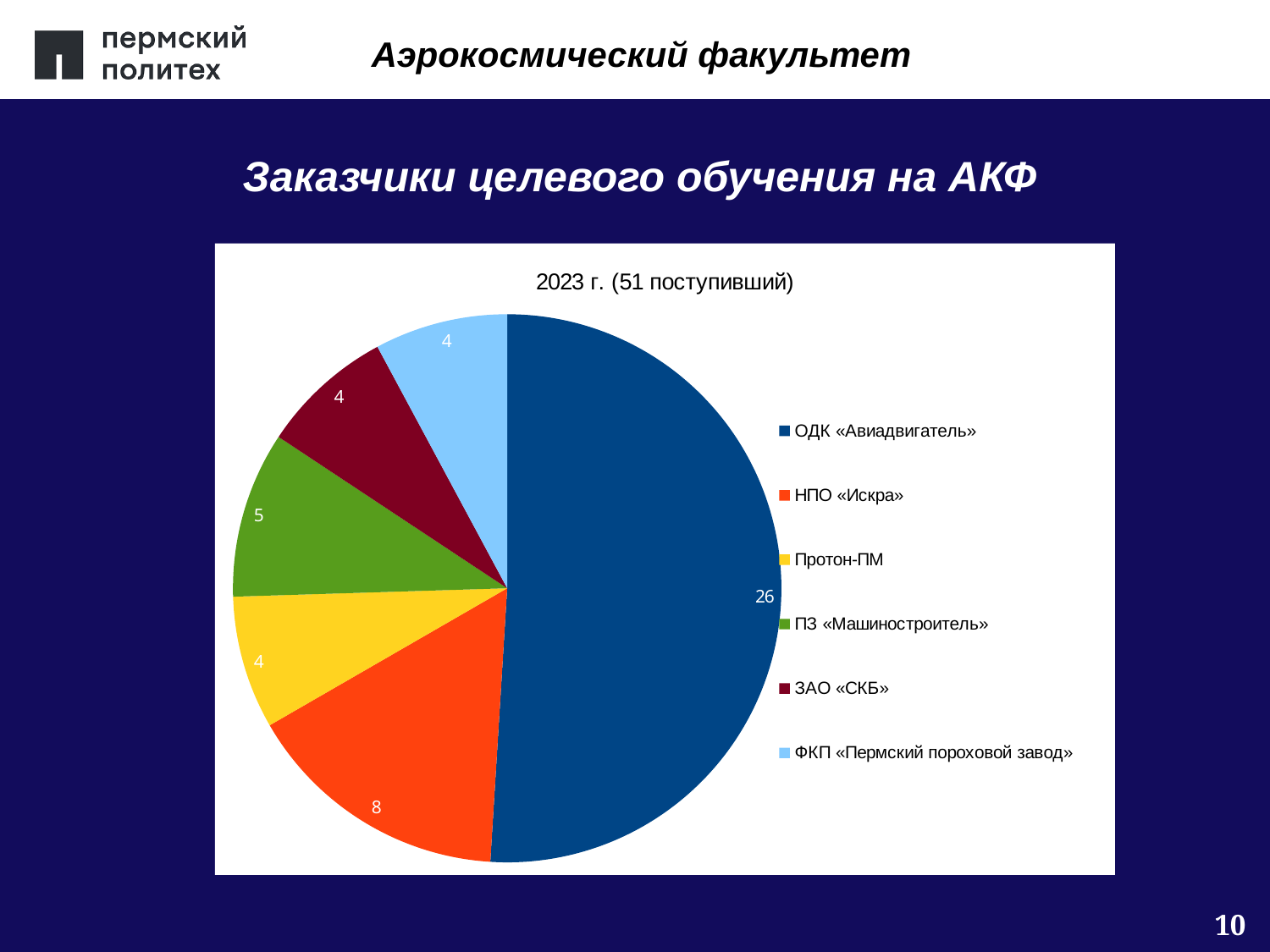
What is the total number of students represented by all slices of the pie? 51 What is the difference between the values for ОДК «Авиадвигатель» and НПО «Искра»? 18 What is the value shown for ПЗ «Машиностроитель»? 5 How many slices does the pie chart have? 6 What is the title of the pie chart? 2023 г. (51 поступивший) What kind of chart is shown on the slide? pie chart What is the value shown for ФКП «Пермский пороховой завод»? 4 Which is larger, the slice for НПО «Искра» or the slice for ПЗ «Машиностроитель»? НПО «Искра» How many students does the slice for ОДК «Авиадвигатель» represent? 26 What is the value shown for НПО «Искра»? 8 Which customer has the largest slice of the pie? ОДК «Авиадвигатель» What is the difference between the values for ПЗ «Машиностроитель» and ЗАО «СКБ»? 1